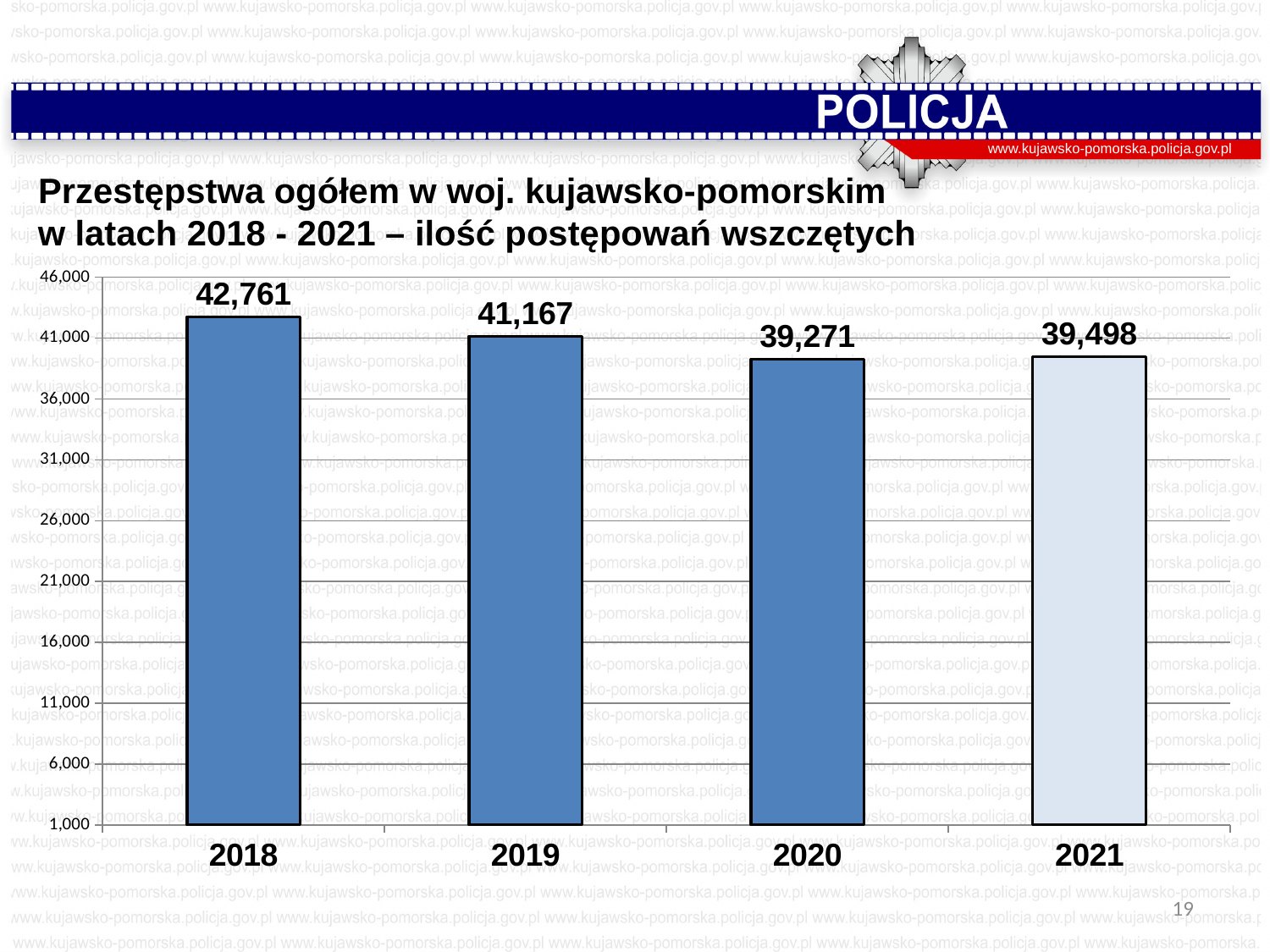
What is the value for 2020? 39,271 What is the value for 2019? 41,167 Which year has the highest value? 2018 Which is larger, the value for 2020 or the value for 2021? 2021 What is the value for 2018? 42,761 What is the difference between the values for 2019 and 2020? 1,896 Which year has the lowest value? 2020 Do the values rise or fall from 2018 to 2020? fall What is the difference between the values for 2018 and 2021? 3,263 How many years are shown on the chart? 4 What kind of chart is this? bar chart What is the value for 2021? 39,498